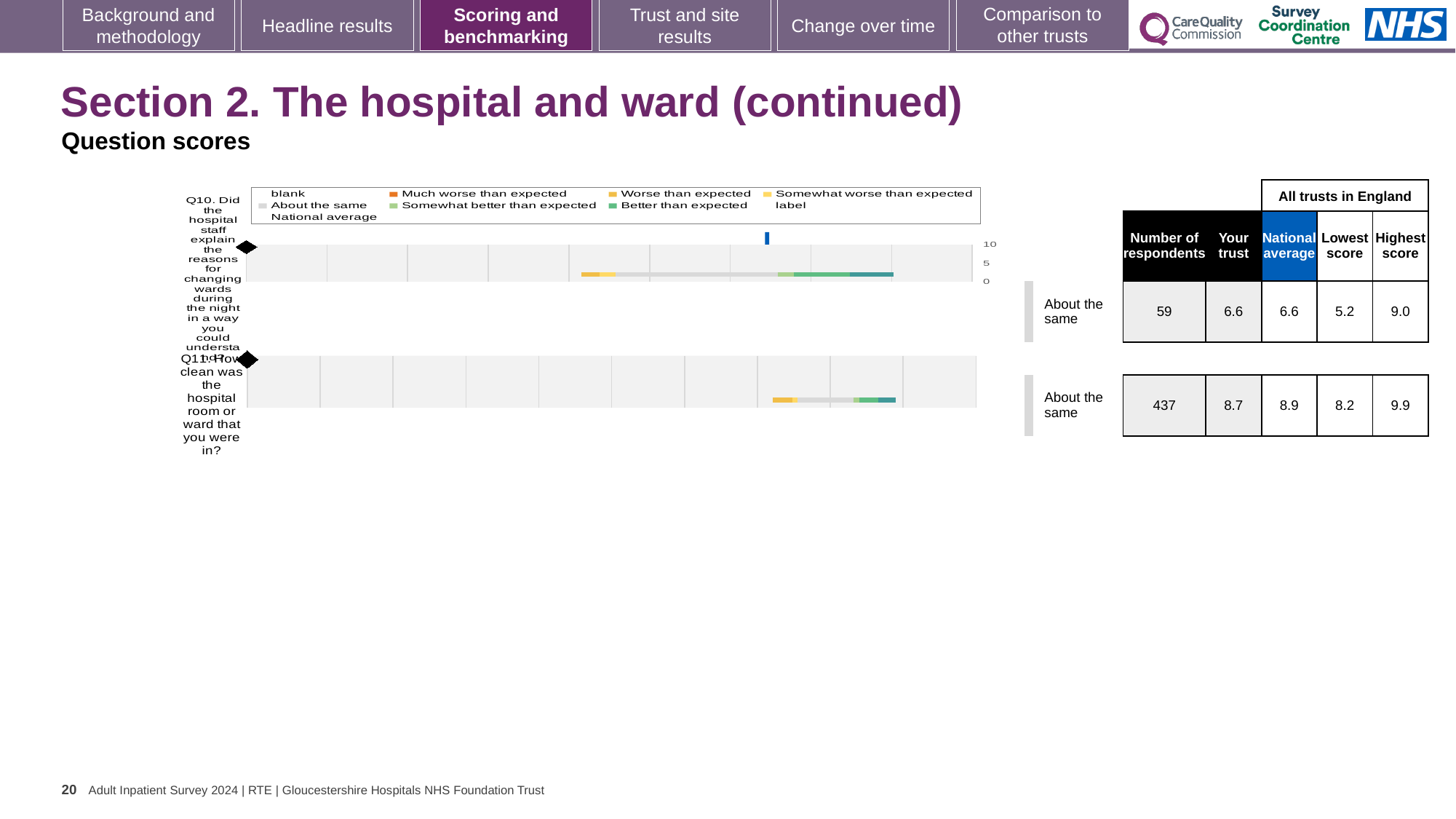
What is the difference between the highest and lowest scores for Q11? 1.7 Is the 'Your trust' score for Q10 higher than, lower than, or the same as the national average? the same What is the highest score among all trusts in England for Q10? 9.0 How many survey questions are plotted on the chart? 2 What is the lowest score among all trusts in England for Q11? 8.2 What is the 'Your trust' score for Q11 (How clean was the hospital room or ward that you were in?)? 8.7 What is the national average score for Q11 (How clean was the hospital room or ward that you were in?)? 8.9 For Q11, which is larger: the 'Your trust' score or the national average? National average How many more respondents answered Q11 than Q10? 378 How many respondents answered Q10 (Did the hospital staff explain the reasons for changing wards during the night)? 59 What kind of chart is used to show the question scores? Bar chart Which benchmarking category is shown for Q10? About the same